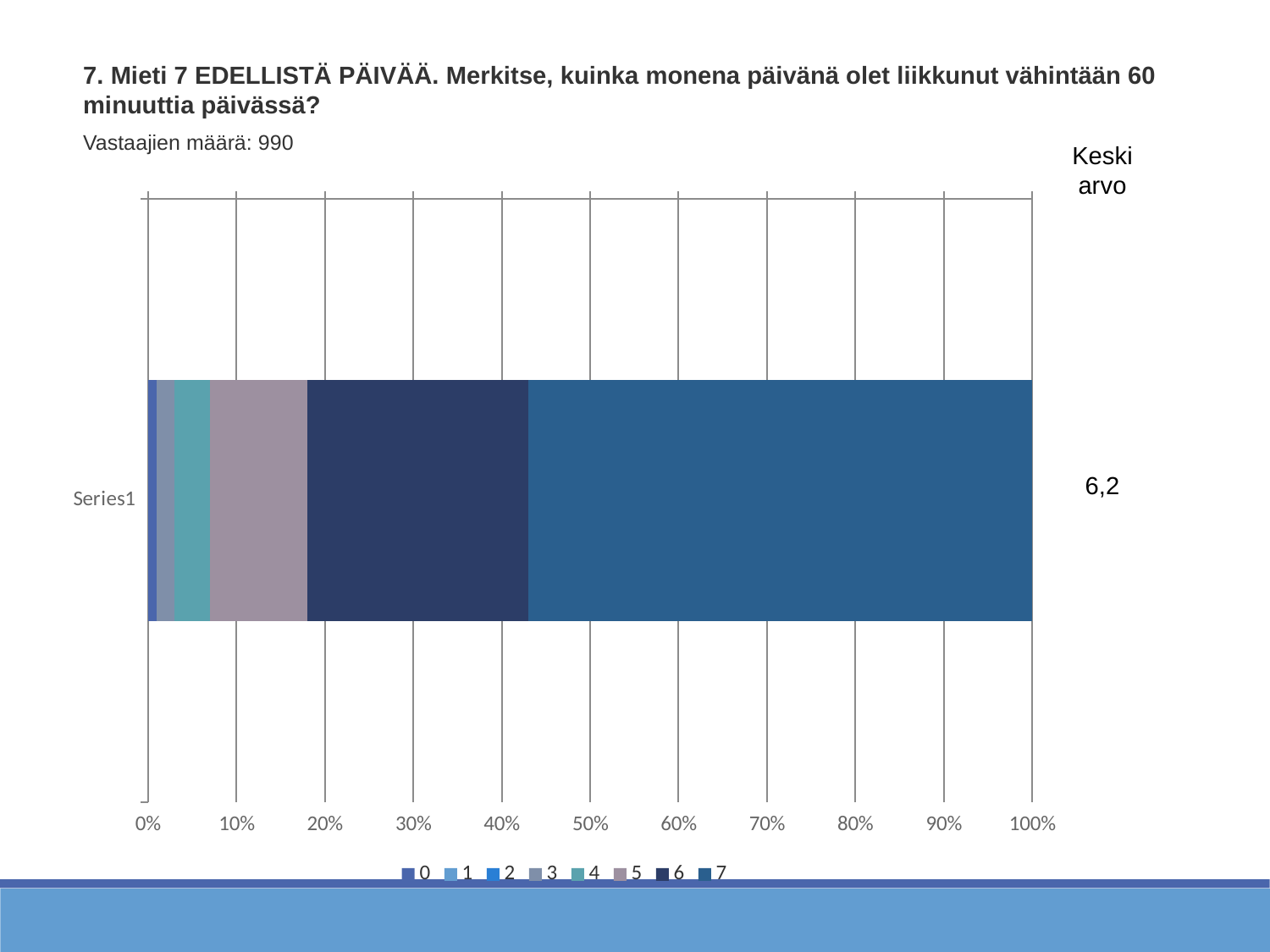
Is the share of series 7 in the Series1 bar greater or less than 50%? greater Which legend series occupies the largest share of the Series1 bar? 7 Is the share of series 6 in the Series1 bar greater or less than 30%? less What is the highest value shown on the horizontal axis? 100% What average value (Keskiarvo) is shown to the right of the chart? 6,2 How many categories are plotted on the vertical axis? 1 Is the share of series 4 in the Series1 bar greater or less than 10%? less How many series does the legend list? 8 Which segment of the Series1 bar is larger, series 6 or series 7? 7 Which segment of the Series1 bar is larger, series 5 or series 6? 6 What kind of chart is shown on the slide? stacked bar chart